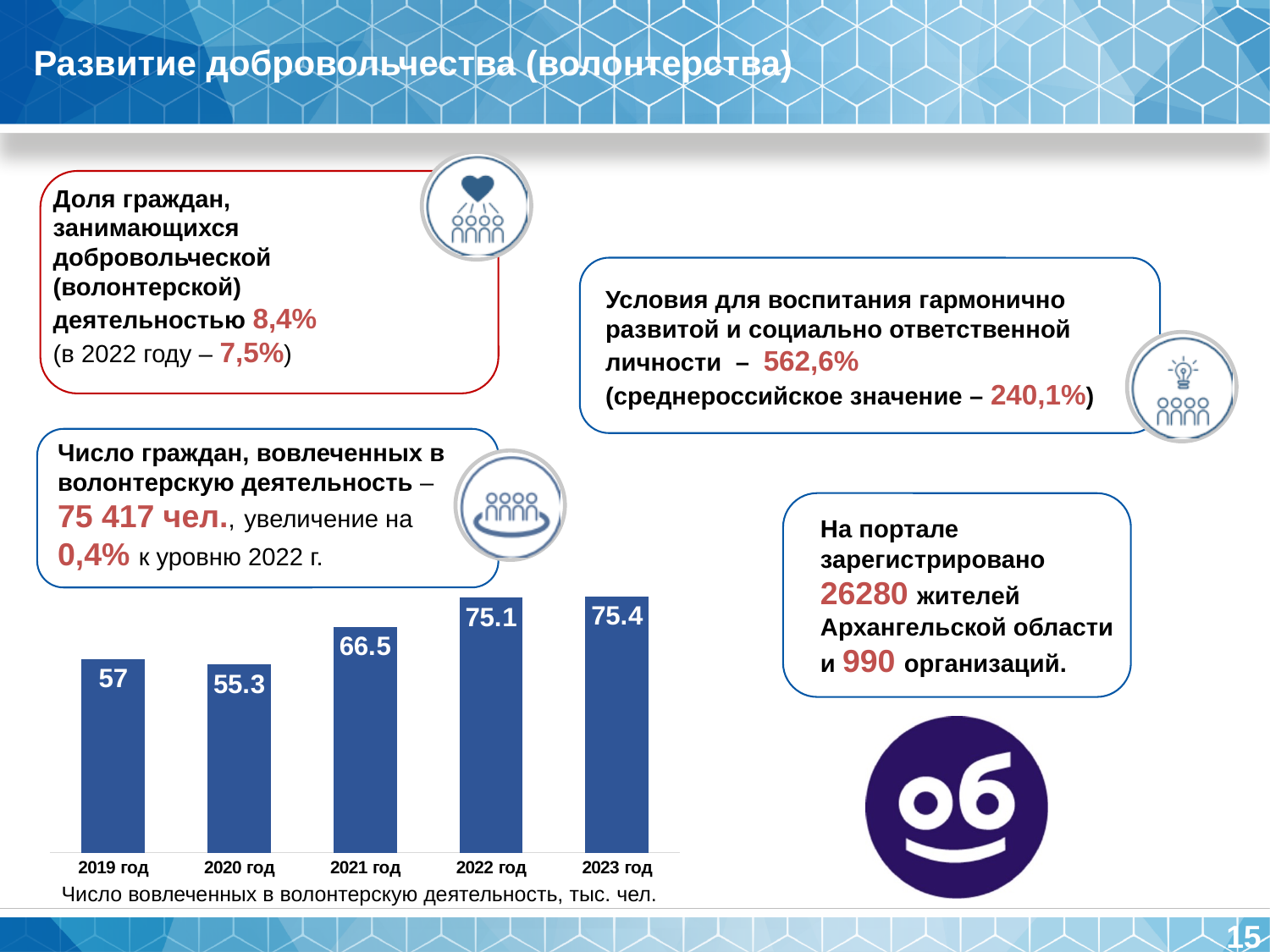
What is the difference between the values for 2023 год and 2022 год in the bar chart? 0.3 What is the difference between the values for 2021 год and 2020 год in the bar chart? 11.2 Do the values in the bar chart generally rise or fall from 2019 год to 2023 год? rise What kind of chart is shown on the slide? bar chart How many years are shown in the bar chart? 5 What is the value for 2021 год in the bar chart? 66.5 Which year has the lowest value in the bar chart? 2020 год Which year has the highest value in the bar chart? 2023 год What is the value for 2019 год in the bar chart? 57 What is the caption below the bar chart? Число вовлеченных в волонтерскую деятельность, тыс. чел. What is the value for 2023 год in the bar chart? 75.4 Which is larger in the bar chart: the value for 2019 год or 2020 год? 2019 год